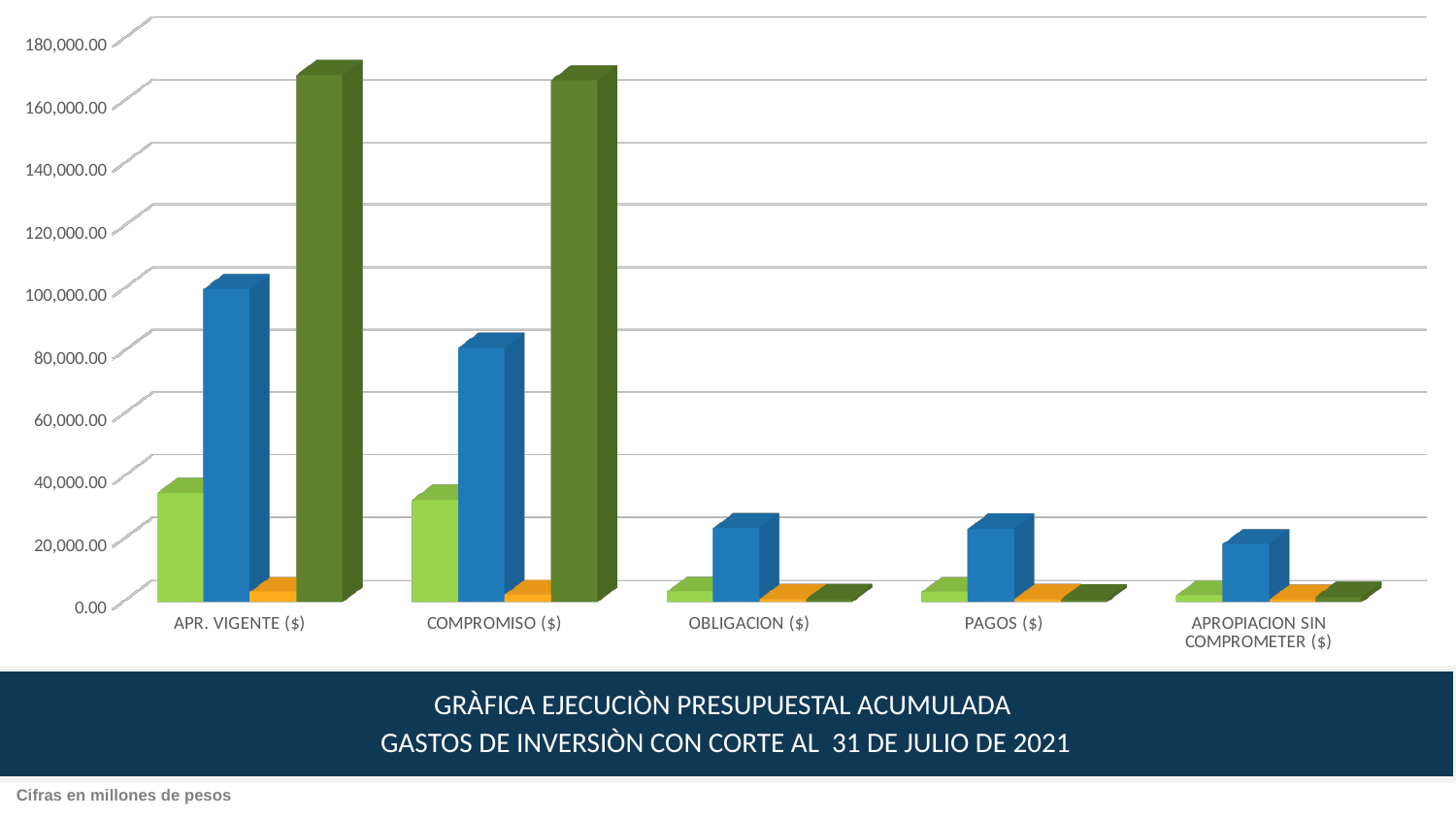
What kind of chart is shown on the slide? bar chart Is the value of the dark green bar for APR. VIGENTE ($) greater or less than 160,000.00? greater Is the value of the light green bar for APR. VIGENTE ($) greater or less than 40,000.00? less What is the highest value shown on the vertical axis of the chart? 180,000.00 Is the value of the blue bar for PAGOS ($) greater or less than 40,000.00? less According to the note below the chart, in what units are the figures expressed? millones de pesos Which category has the tallest blue bar? APR. VIGENTE ($) Which is larger, the blue bar for APR. VIGENTE ($) or the blue bar for COMPROMISO ($)? APR. VIGENTE ($) How many categories are shown on the x axis of the chart? 5